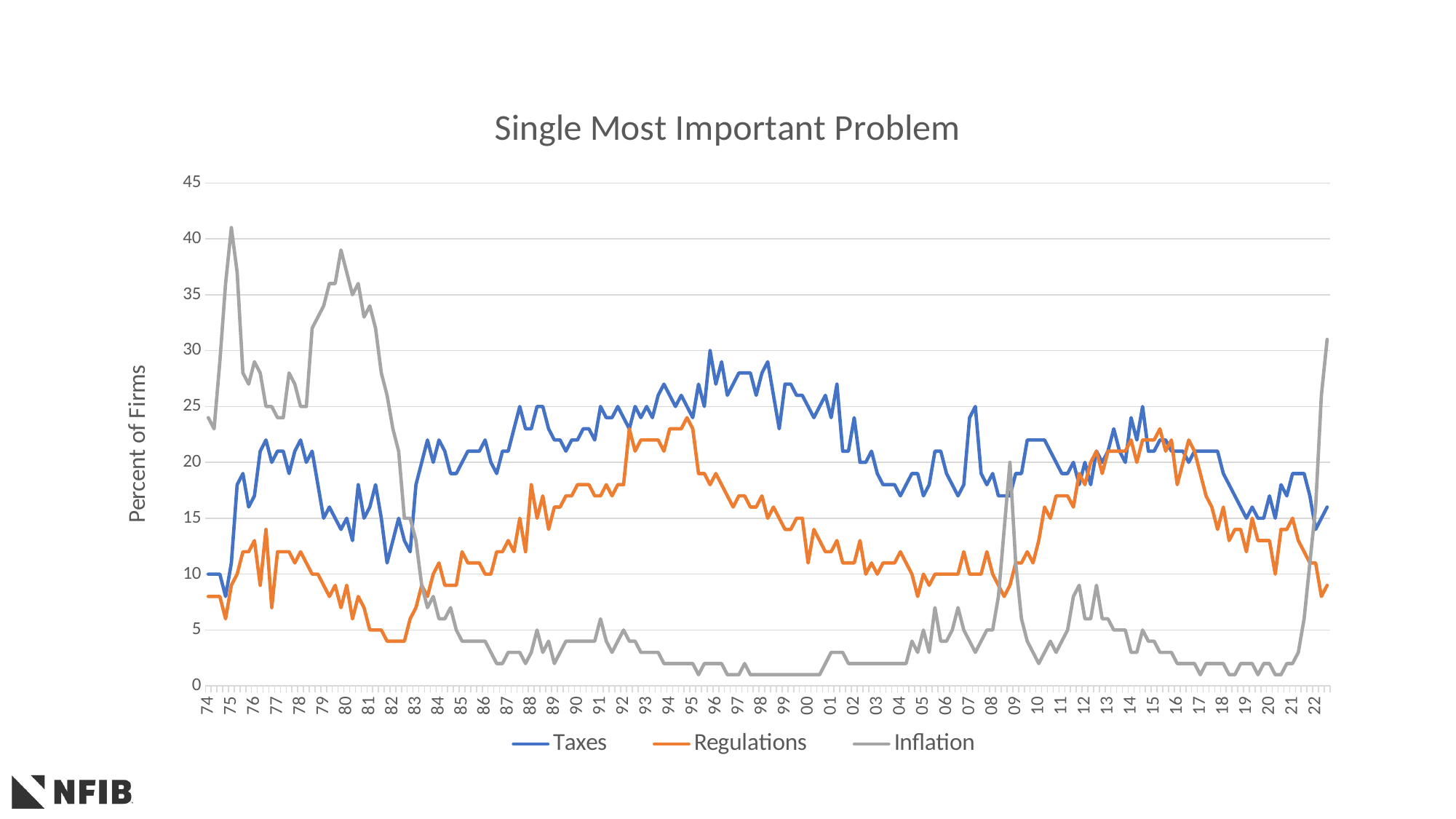
Is the peak value for Inflation around 1980 greater or less than 35? greater At the right end of the chart in 2022, which series is higher, Inflation or Regulations? Inflation Is the value for Inflation around 1998 greater or less than 5? less How many series does the legend list? 3 Is the peak value for Taxes around 1996 greater or less than 25? greater Does the Inflation line rise or fall from 1980 to 1983? Fall What is the title of the chart? Single Most Important Problem Which series reaches the highest value anywhere on the chart? Inflation What is the label on the vertical axis? Percent of Firms What kind of chart is shown on the slide? Line chart Around 1980, which series is higher, Inflation or Taxes? Inflation